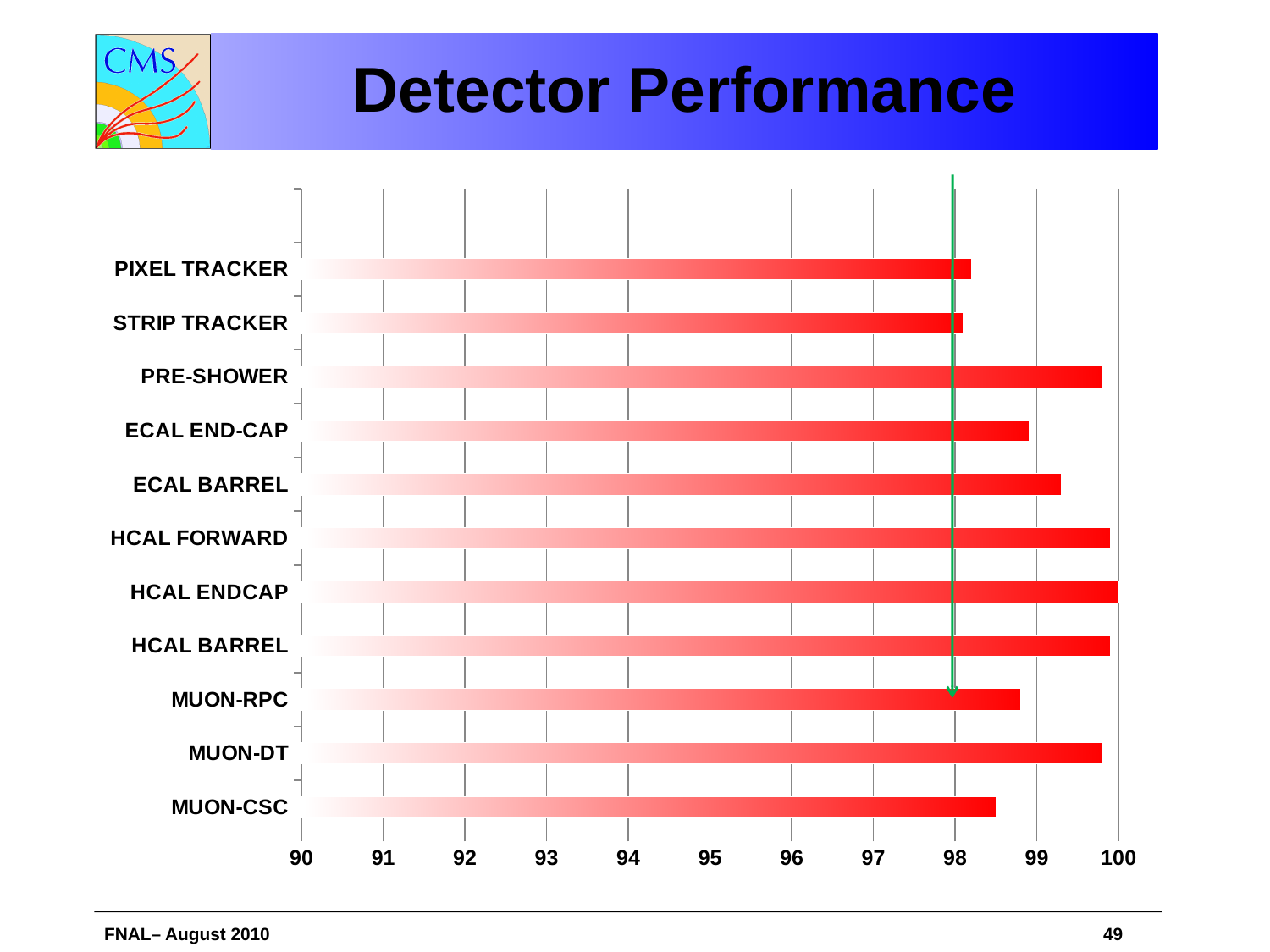
At which x-axis value is the green vertical line drawn? 98 What kind of chart is shown on the slide? bar chart Is the value for MUON-RPC greater or less than 99? less Which has the larger value, ECAL BARREL or ECAL END-CAP? ECAL BARREL What is the title of the slide containing the chart? Detector Performance Is the value for ECAL BARREL greater or less than 99? greater Which has the larger value, PRE-SHOWER or PIXEL TRACKER? PRE-SHOWER Is the value for MUON-CSC greater or less than 98? greater How many detector categories are plotted in the chart? 11 Which has the larger value, MUON-DT or MUON-CSC? MUON-DT